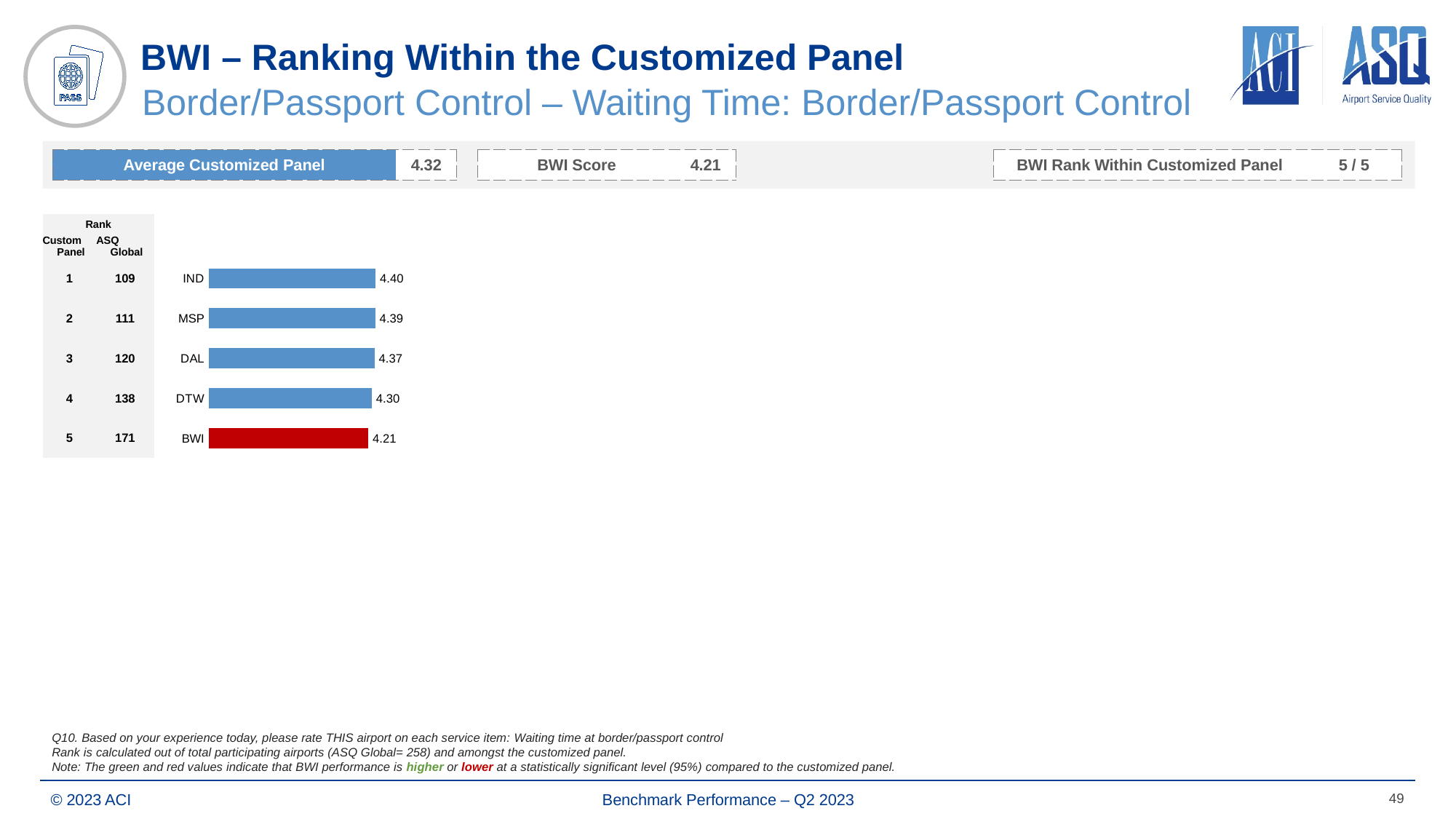
What is the value for BWI? 4.21 Which has a larger value, DAL or DTW? DAL What is the difference between the values for MSP and DTW? 0.09 What kind of chart is shown? Bar chart What is the difference between the values for IND and BWI? 0.19 Which bar is coloured red? BWI What is the value for DTW? 4.30 Which airport has the lowest value? BWI Which airport has the highest value? IND What is the value for DAL? 4.37 What is the value for IND? 4.40 How many airports are shown in the chart? 5